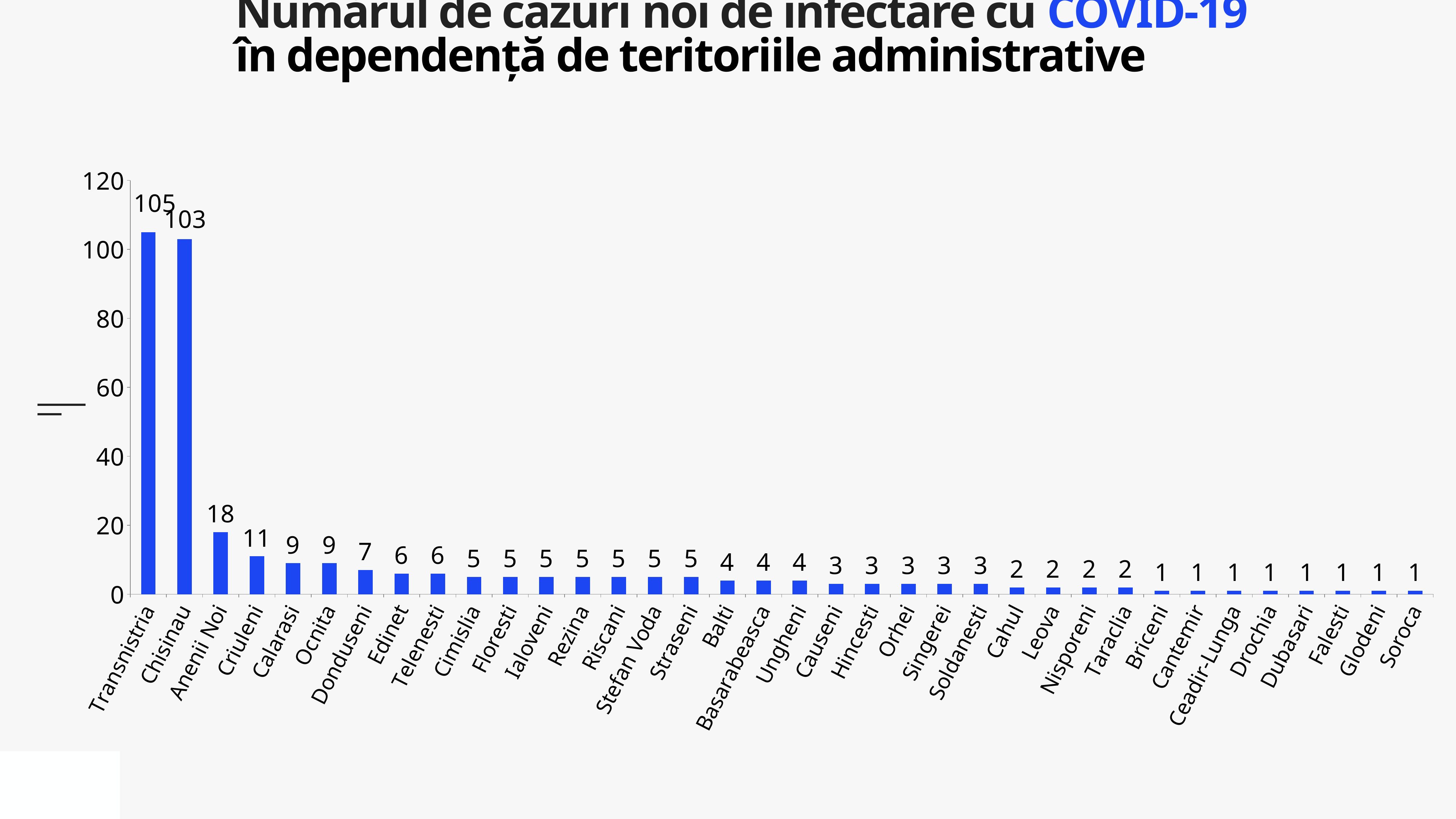
Which is larger, the value for Calarasi or the value for Edinet? Calarasi What is the value for Chisinau? 103 Which territory has the highest number of new cases? Transnistria What is the value for Anenii Noi? 18 What is the difference between the values for Transnistria and Chisinau? 2 What is the value for Criuleni? 11 How many territories are shown on the x axis? 36 What is the value for Donduseni? 7 What is the value for Ungheni? 4 What kind of chart is shown on the slide? bar chart Is the value for Transnistria greater or less than 100? greater What is the difference between the values for Anenii Noi and Criuleni? 7